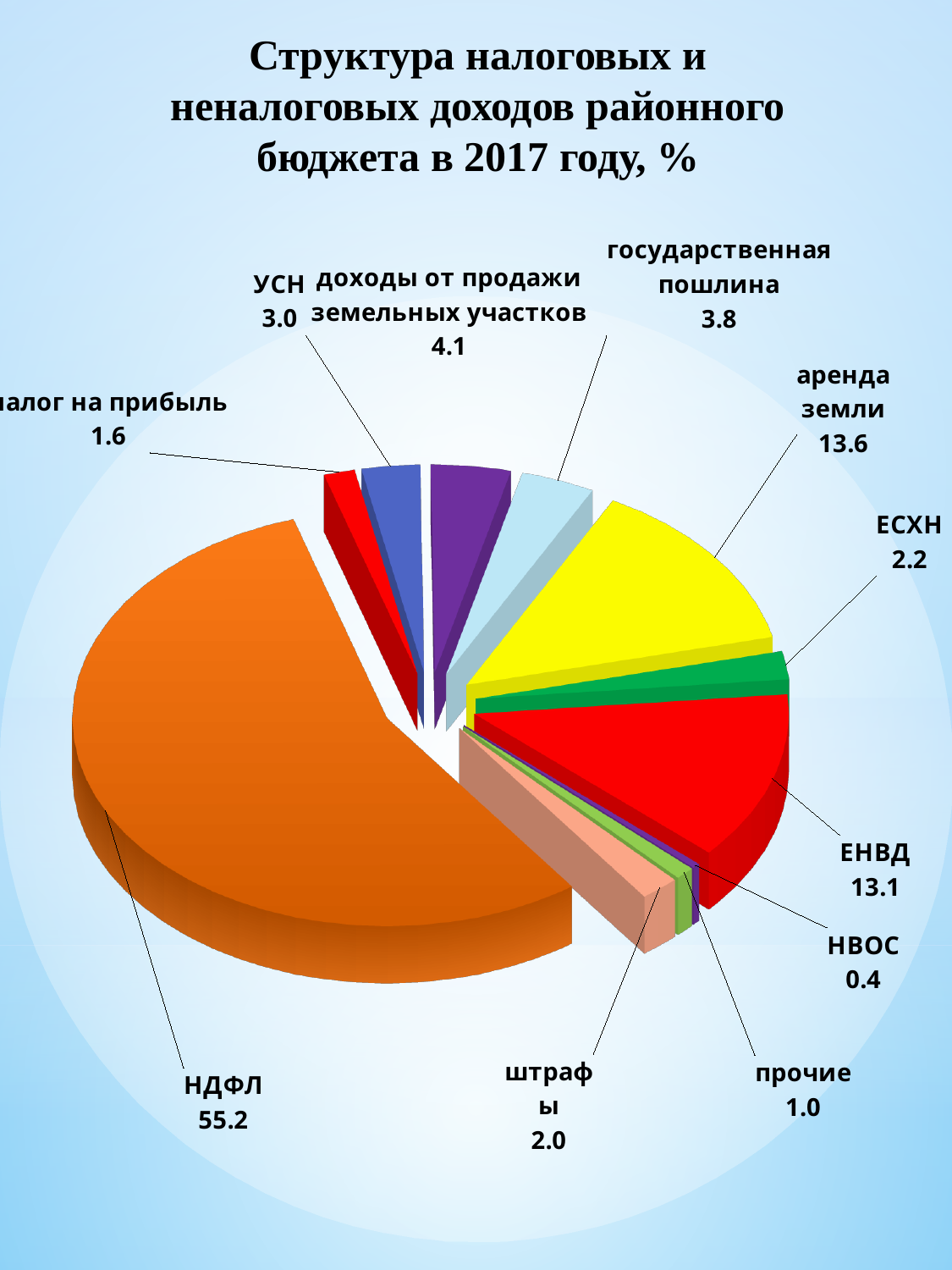
What is the value for доходы от продажи земельных участков? 4.1 What is the difference between the values for НДФЛ and аренда земли? 41.6 Which is larger, the value for УСН or the value for государственная пошлина? государственная пошлина What is the value for НДФЛ? 55.2 Which category has the largest slice of the pie? НДФЛ How many categories are shown in the pie chart? 11 Which category has the smallest slice of the pie? НВОС What is the value for аренда земли? 13.6 What is the difference between the values for аренда земли and ЕНВД? 0.5 What is the title of the chart? Структура налоговых и неналоговых доходов районного бюджета в 2017 году, % What type of chart is shown on the slide? pie chart What is the value for ЕНВД? 13.1